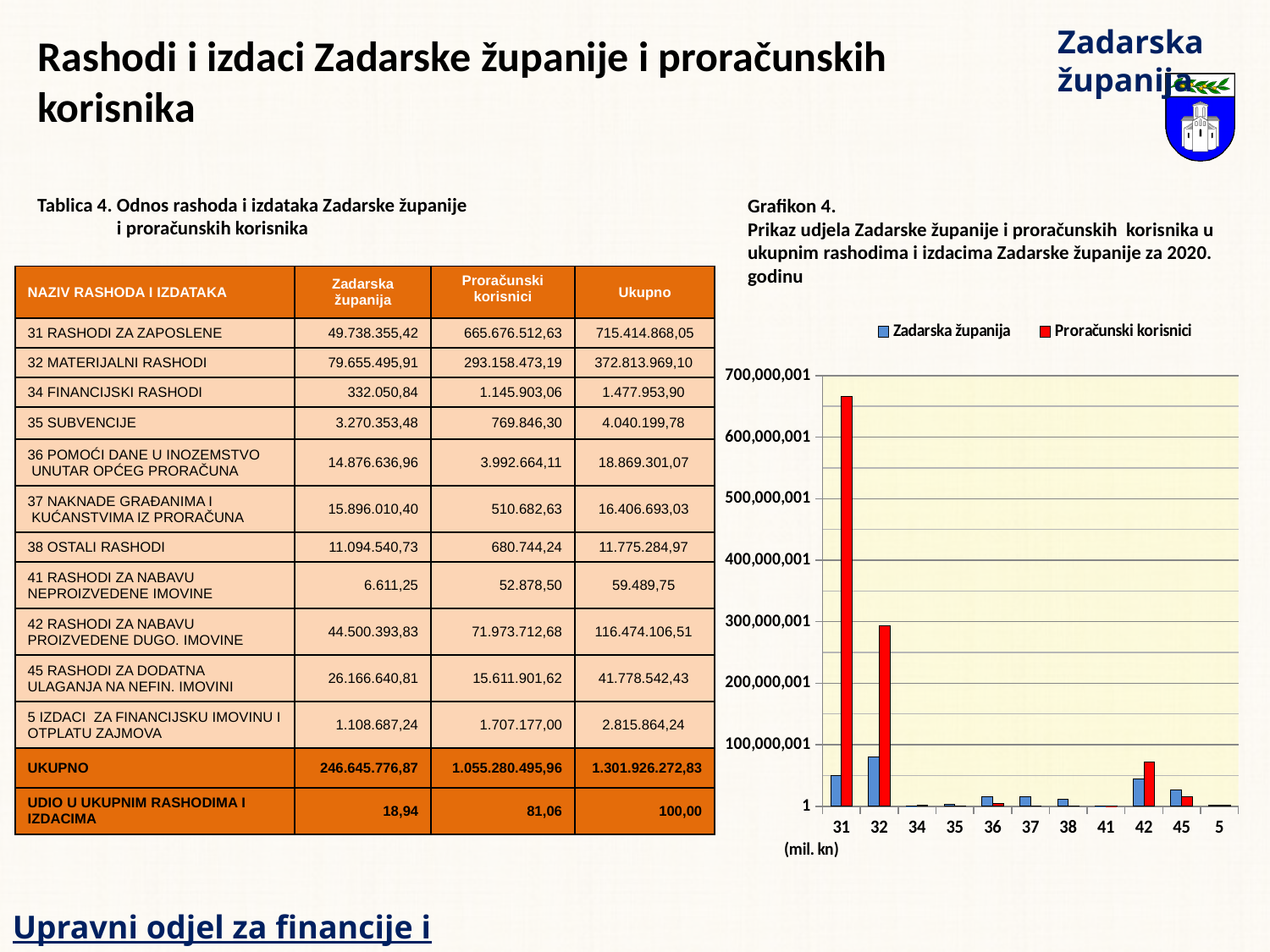
In Grafikon 4, is the Zadarska županija value for category 32 greater or less than 100,000,001? less In Grafikon 4, is the Proračunski korisnici value for category 31 greater or less than 600,000,001? greater What unit label is shown below the x axis of Grafikon 4? (mil. kn) In Grafikon 4, which colour represents the Proračunski korisnici series? red In Grafikon 4, for which category is the Zadarska županija bar the highest? 32 In Grafikon 4, for which category is the Proračunski korisnici bar the highest? 31 What kind of chart is Grafikon 4? bar chart How many categories are shown on the x axis of Grafikon 4? 11 In Grafikon 4, which series has the larger value for category 42, Zadarska županija or Proračunski korisnici? Proračunski korisnici How many series does the legend of Grafikon 4 list? 2 In Grafikon 4, which series has the larger value for category 45, Zadarska županija or Proračunski korisnici? Zadarska županija